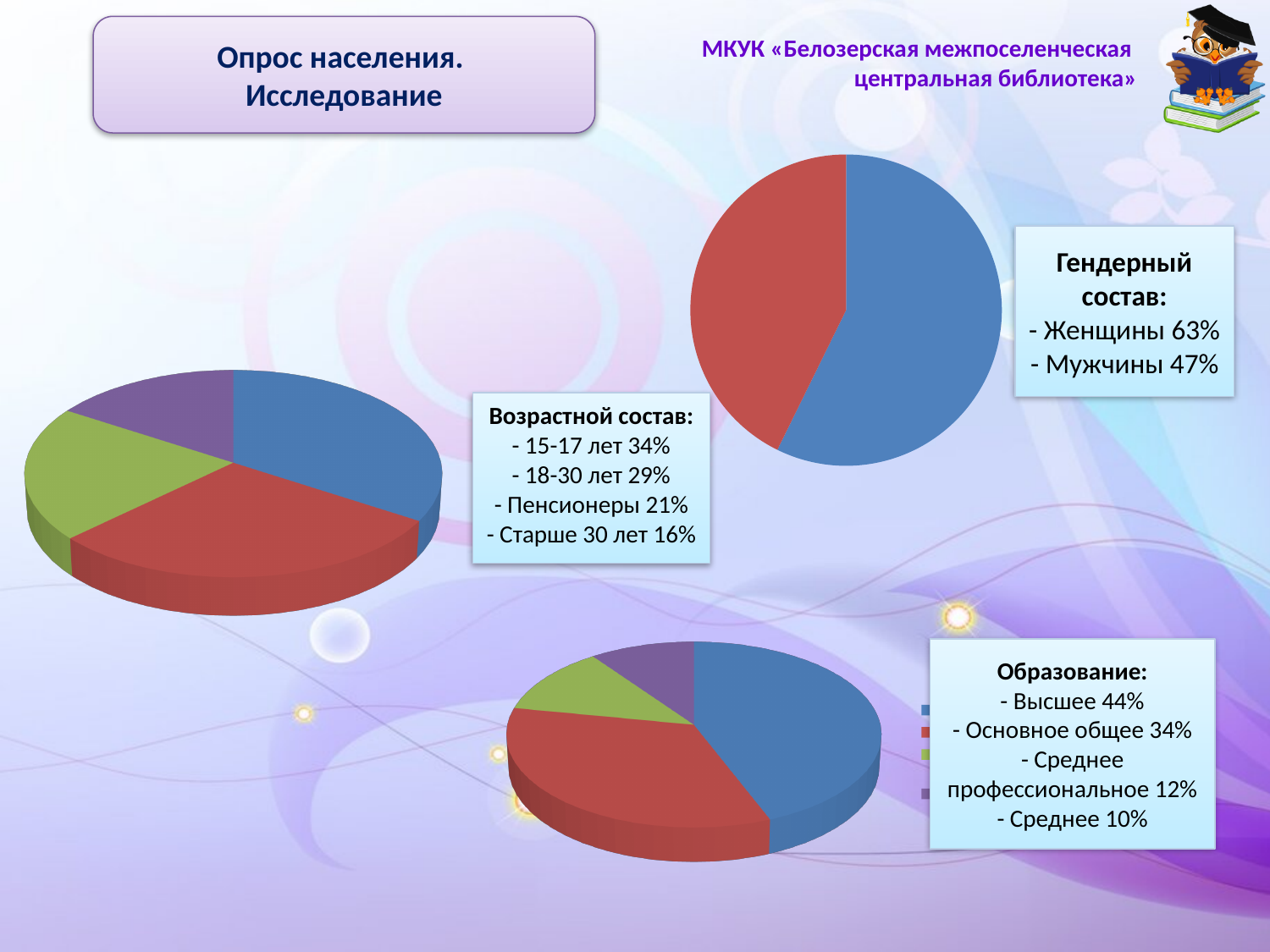
In the education (Образование) pie chart at the bottom, what is the difference between Высшее and Основное общее? 10 percentage points In the age composition (Возрастной состав) pie chart on the left, which category has the smallest share? Старше 30 лет In the age composition (Возрастной состав) pie chart on the left, what is the difference between 15-17 лет and 18-30 лет? 5 percentage points In the education (Образование) pie chart at the bottom, which category has the smallest share? Среднее In the gender composition (Гендерный состав) pie chart at the top right, what is the value for Женщины? 63% In the age composition (Возрастной состав) pie chart on the left, what is the value for 15-17 лет? 34% In the education (Образование) pie chart at the bottom, what is the value for Высшее? 44% In the gender composition (Гендерный состав) pie chart at the top right, which is larger, Женщины or Мужчины? Женщины What type of chart is the gender composition (Гендерный состав) chart at the top right? Pie chart In the age composition (Возрастной состав) pie chart on the left, which category has the largest share? 15-17 лет In the age composition (Возрастной состав) pie chart on the left, what is the value for Пенсионеры? 21% In the age composition (Возрастной состав) pie chart on the left, how many categories are shown? 4